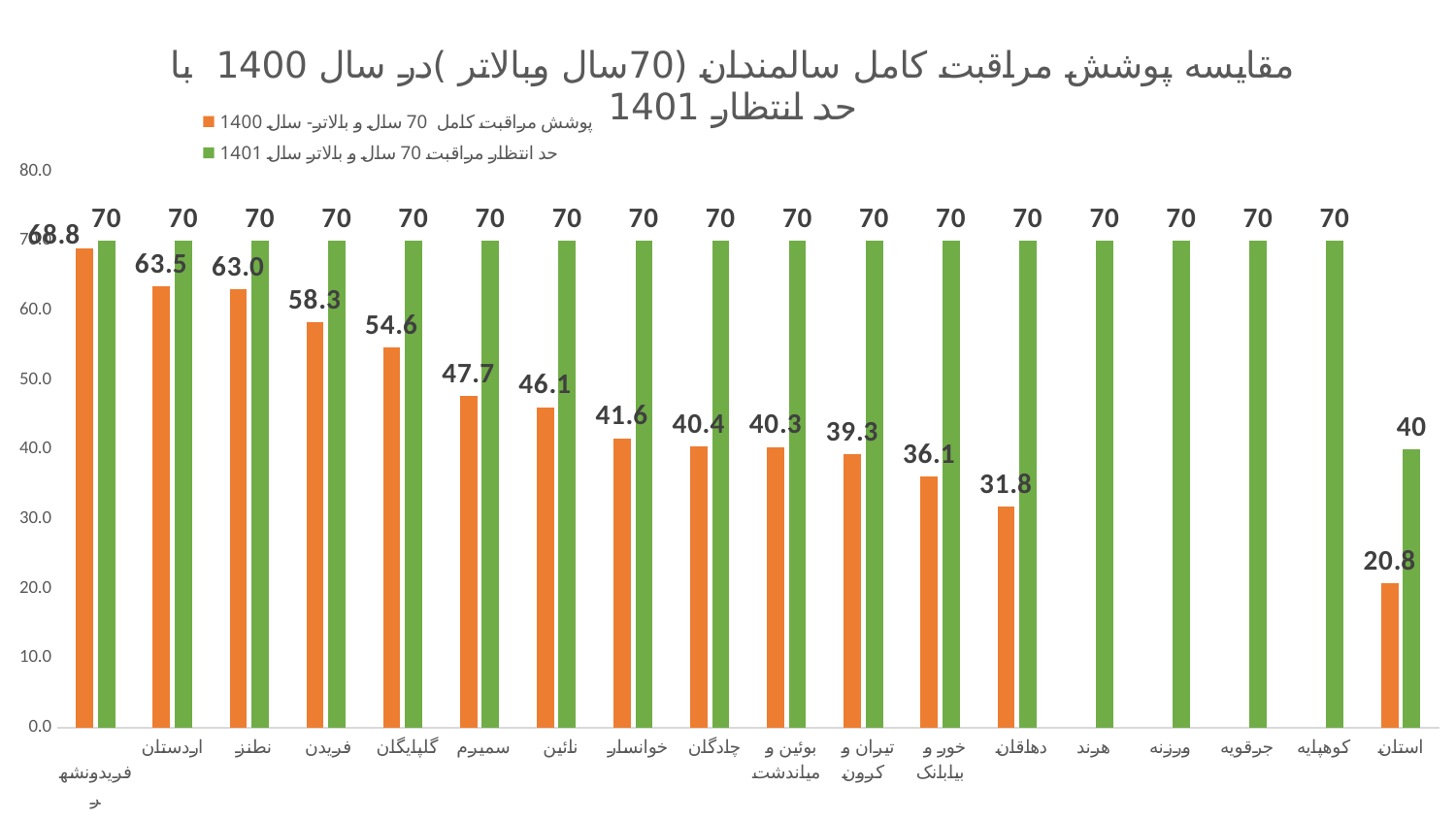
What is the expected level (green bar) for استان? 40 Which is larger: the 1400 coverage value for سمیرم or for نائین? سمیرم How many categories are shown on the x axis? 18 What is the 1400 coverage value (orange bar) for گلپایگان? 54.6 What is the difference between the expected level (green bar) and the 1400 coverage (orange bar) for فریدن? 11.7 What is the 1400 coverage value (orange bar) for دهاقان? 31.8 How many series does the legend list? 2 Which category has the highest 1400 coverage value (orange bar)? فریدونشهر What is the 1400 coverage value (orange bar) for اردستان? 63.5 Which category has the lowest 1400 coverage value (orange bar) among those with a labelled orange bar? استان What kind of chart is shown on the slide? Bar chart Which colour represents the 1401 expected level series (حد انتظار مراقبت 70 سال و بالاتر سال 1401)? Green